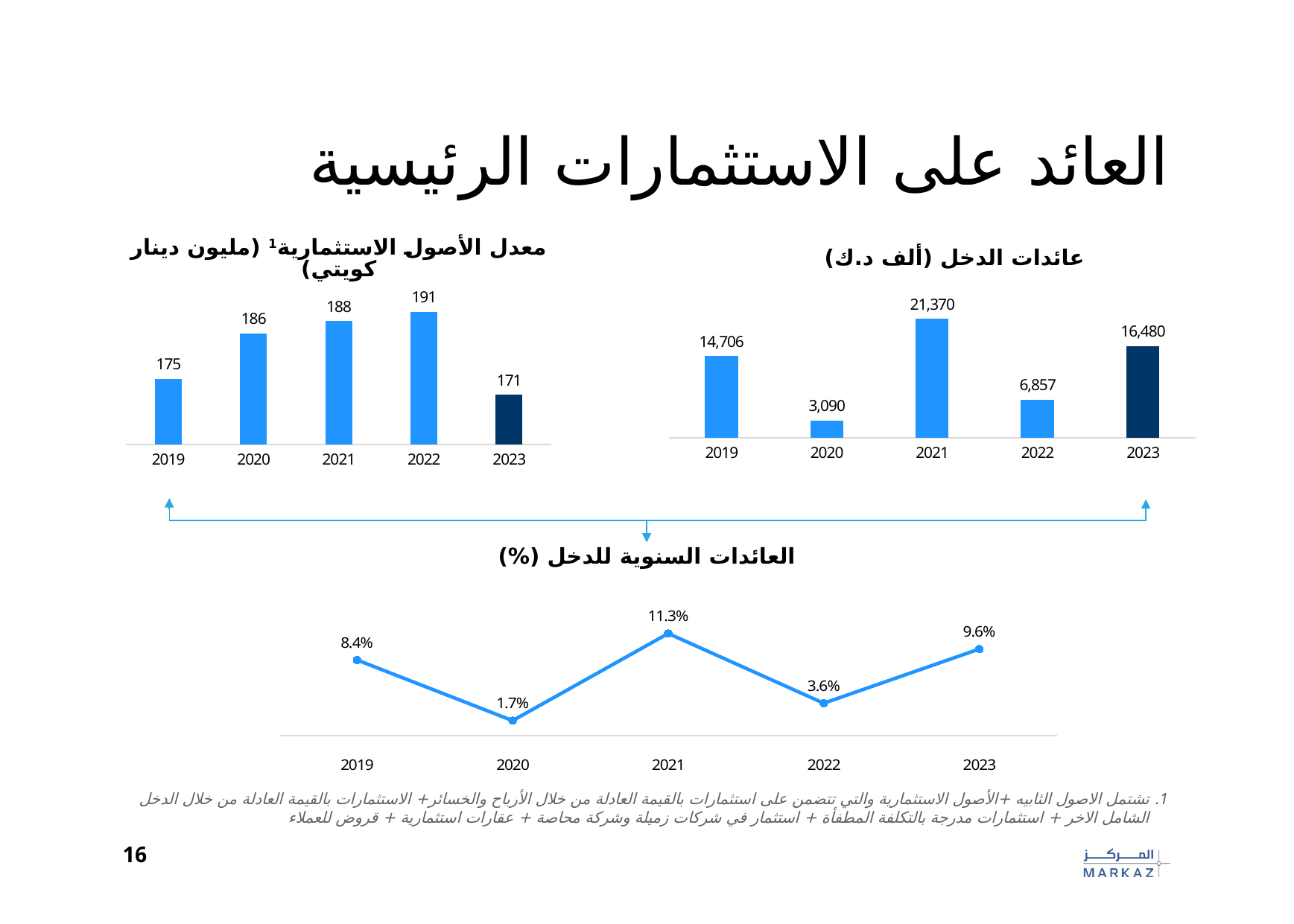
In the top-left chart (معدل الأصول الاستثمارية), what is the difference between the 2022 and 2019 values? 16 In the bottom line chart (العائدات السنوية للدخل), is the value for 2019 or 2023 larger? 2023 How many years are plotted in the bottom line chart (العائدات السنوية للدخل)? 5 In the top-right chart (عائدات الدخل), which year has the lowest value? 2020 In the top-left chart (معدل الأصول الاستثمارية), what is the value for 2022? 191 In the top-right chart (عائدات الدخل), which year's bar is shown in a darker blue than the others? 2023 What type of chart is the top-right chart (عائدات الدخل)? Bar chart In the top-right chart (عائدات الدخل), what is the difference between the 2023 and 2022 values? 9,623 In the bottom line chart (العائدات السنوية للدخل), which year has the lowest value? 2020 In the top-right chart (عائدات الدخل), what is the value for 2021? 21,370 In the top-left chart (معدل الأصول الاستثمارية), which year has the lowest value? 2023 In the bottom line chart (العائدات السنوية للدخل), what is the value for 2021? 11.3%